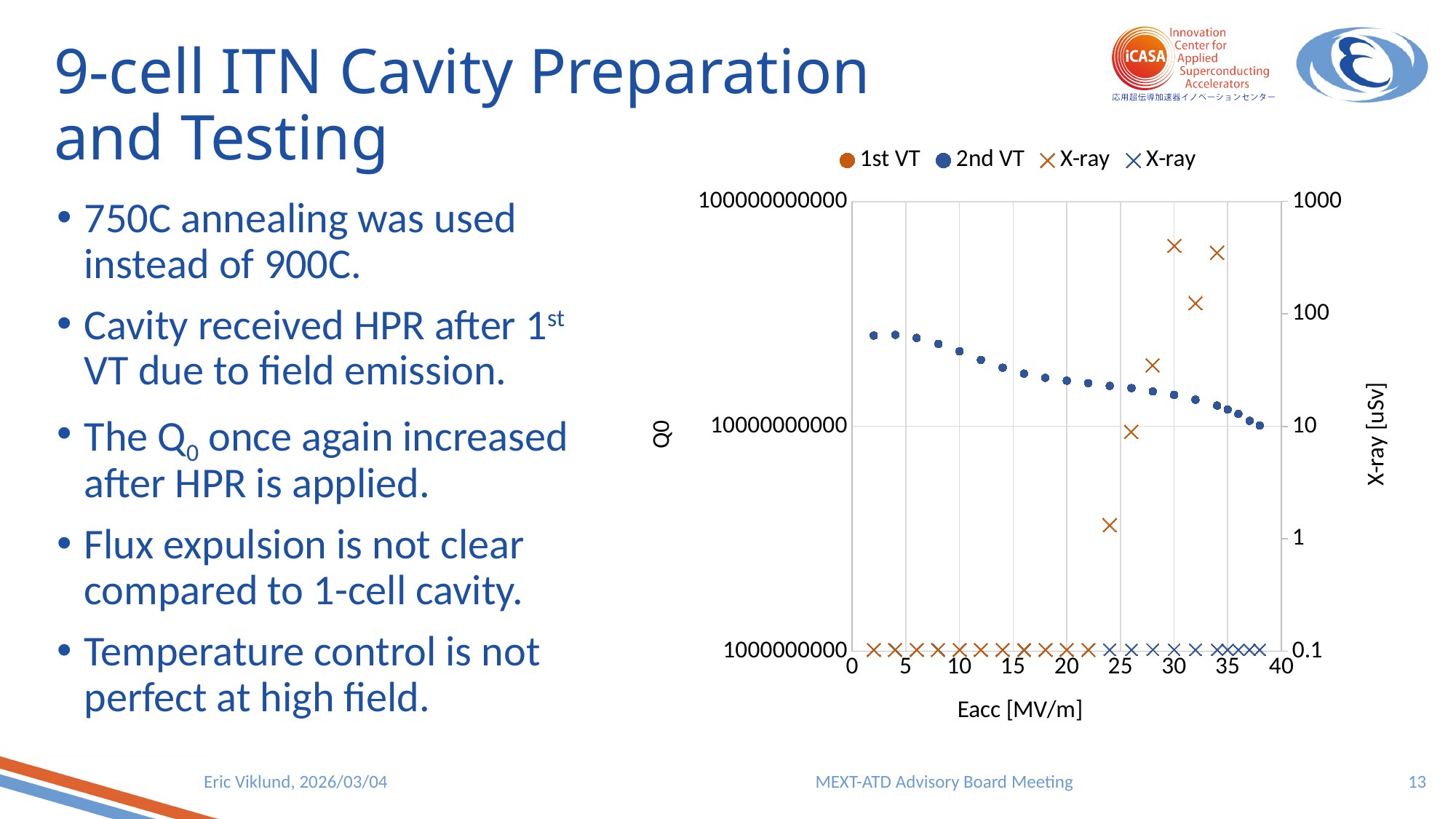
Is the 2nd VT Q0 value at Eacc = 20 MV/m greater or less than 10000000000? greater Is the 2nd VT Q0 value at Eacc = 2 MV/m greater or less than 100000000000? less What kind of chart is shown on the slide? scatter chart Is the orange X-ray value at Eacc = 28 MV/m greater or less than 10 uSv? greater What is the title of the x axis of the chart? Eacc [MV/m] How many series does the chart legend list? 4 What is the title of the right-hand (secondary) y axis of the chart? X-ray [uSv] Do the 2nd VT Q0 values rise or fall as Eacc increases? fall Which is larger, the orange X-ray value at Eacc = 30 MV/m or at Eacc = 24 MV/m? Eacc = 30 MV/m